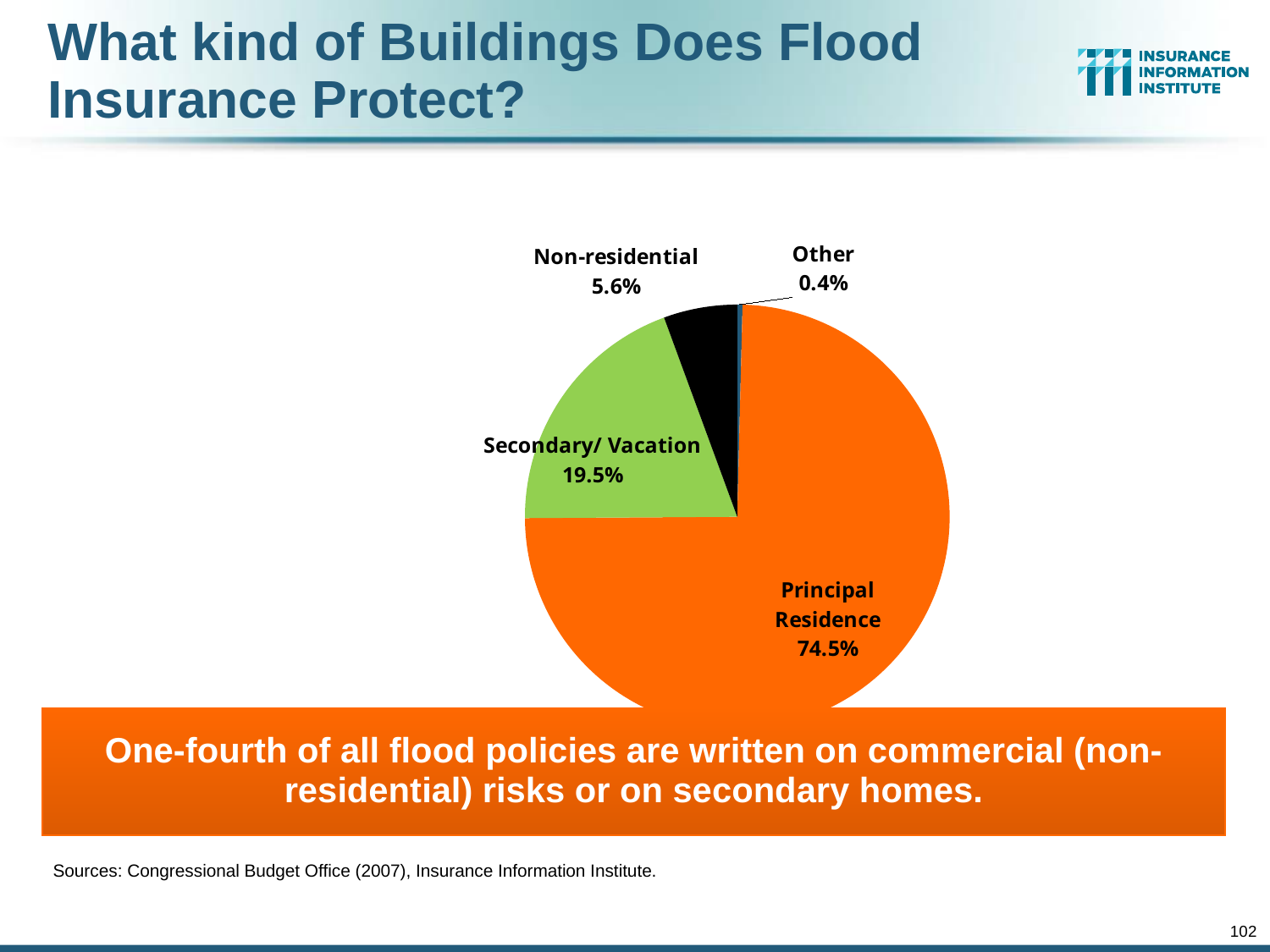
What kind of chart is shown on the slide? Pie chart What is the value shown for the Other slice? 0.4% What colour is the Secondary/ Vacation slice? Green Which is larger, the Non-residential slice or the Secondary/ Vacation slice? Secondary/ Vacation What share of the pie does Principal Residence account for? 74.5% What is the value shown for Secondary/ Vacation? 19.5% What is the difference in percentage points between Secondary/ Vacation and Non-residential? 13.9 percentage points How many categories are shown in the pie chart? 4 Which category has the smallest slice of the pie? Other Which category has the largest slice of the pie? Principal Residence What is the difference in percentage points between Principal Residence and Secondary/ Vacation? 55 percentage points What is the value shown for Non-residential? 5.6%